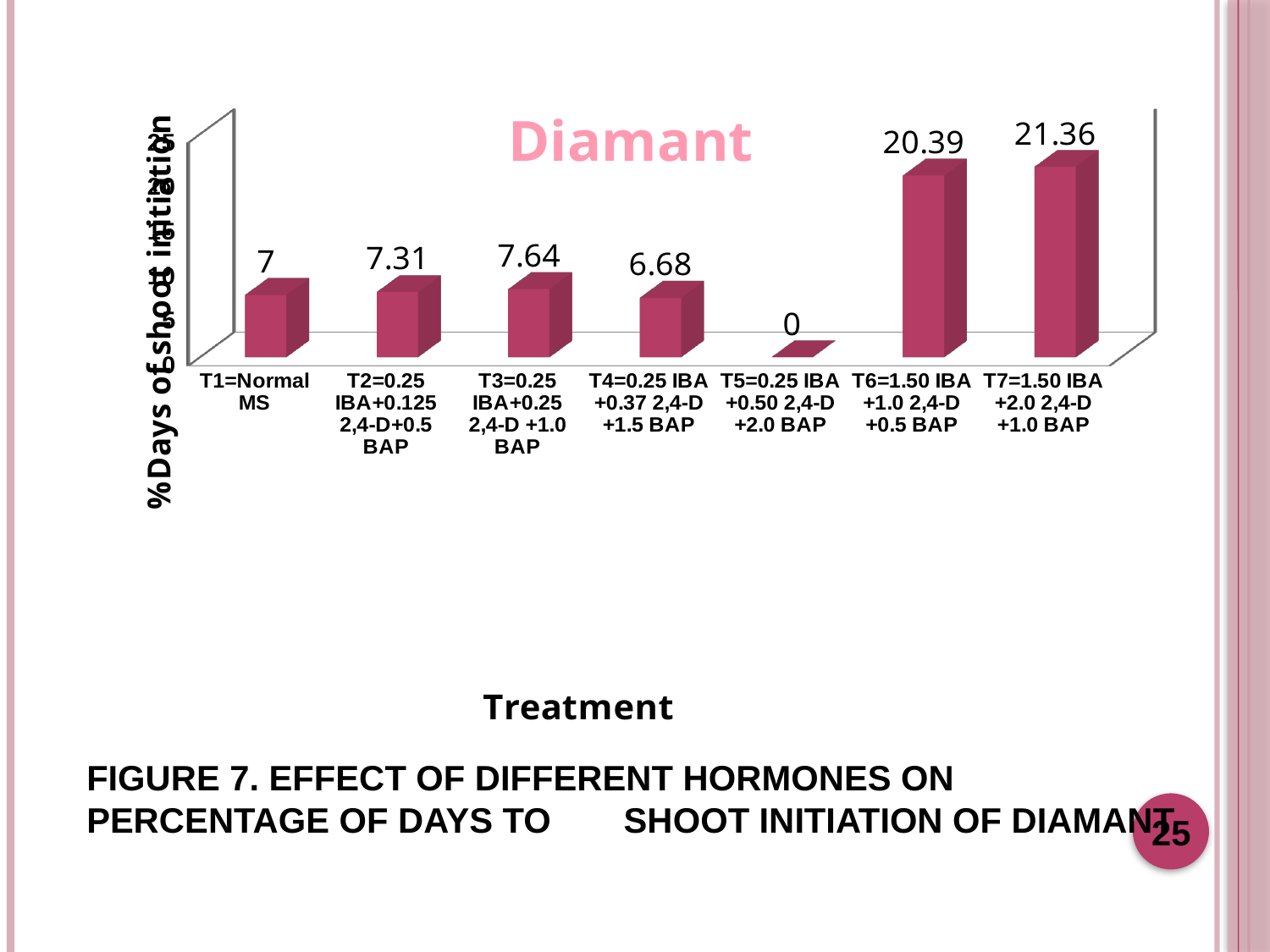
What is the value for T6=1.50 IBA +1.0 2,4-D +0.5 BAP? 20.39 What is the value for T5=0.25 IBA +0.50 2,4-D +2.0 BAP? 0 What is the value for T1=Normal MS? 7 What is the value for T3=0.25 IBA+0.25 2,4-D +1.0 BAP? 7.64 Which treatment has the lowest value? T5=0.25 IBA +0.50 2,4-D +2.0 BAP What kind of chart is this? bar chart What is the title of the chart? Diamant What is the difference between the values for T7 and T6? 0.97 Which is larger, the value for T2 or the value for T4? T2 How many treatments are shown on the x axis? 7 Which treatment has the highest value? T7=1.50 IBA +2.0 2,4-D +1.0 BAP What is the difference between the values for T3 and T4? 0.96